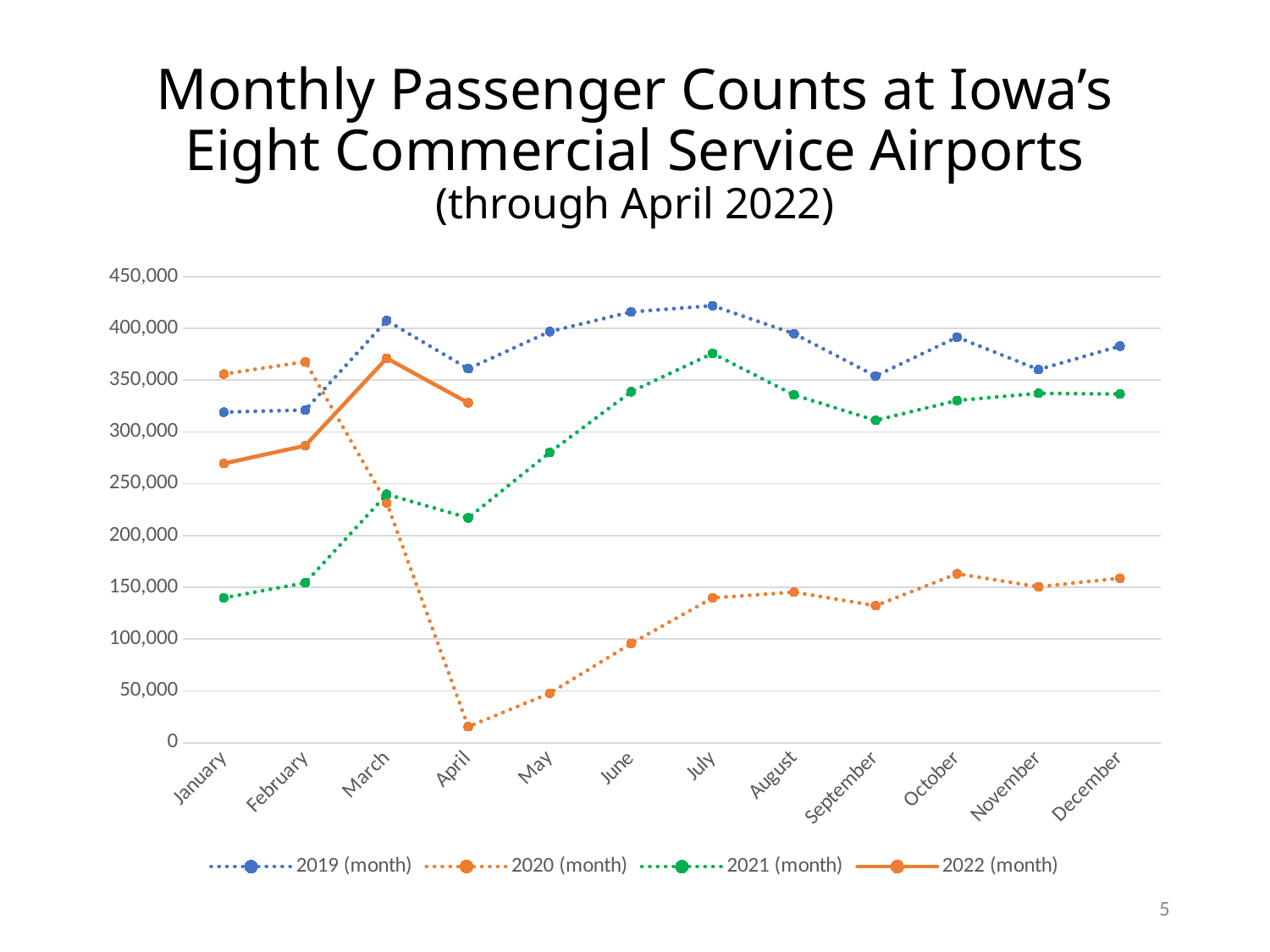
Does the 2022 (month) series rise or fall from January to March? rise Is the value for 2020 (month) in April greater or less than 50,000? less Is the value for 2022 (month) in March greater or less than 350,000? greater How many series does the legend list? 4 In which month does the 2019 (month) series reach its highest value? July In February, which series has the larger value: 2020 (month) or 2022 (month)? 2020 (month) In which month does the 2022 (month) series reach its highest value? March In which month does the 2020 (month) series reach its lowest value? April In July, which series has the larger value: 2019 (month) or 2021 (month)? 2019 (month) In which month does the 2021 (month) series reach its highest value? July How many months are shown along the x axis? 12 What kind of chart is shown on the slide? line chart